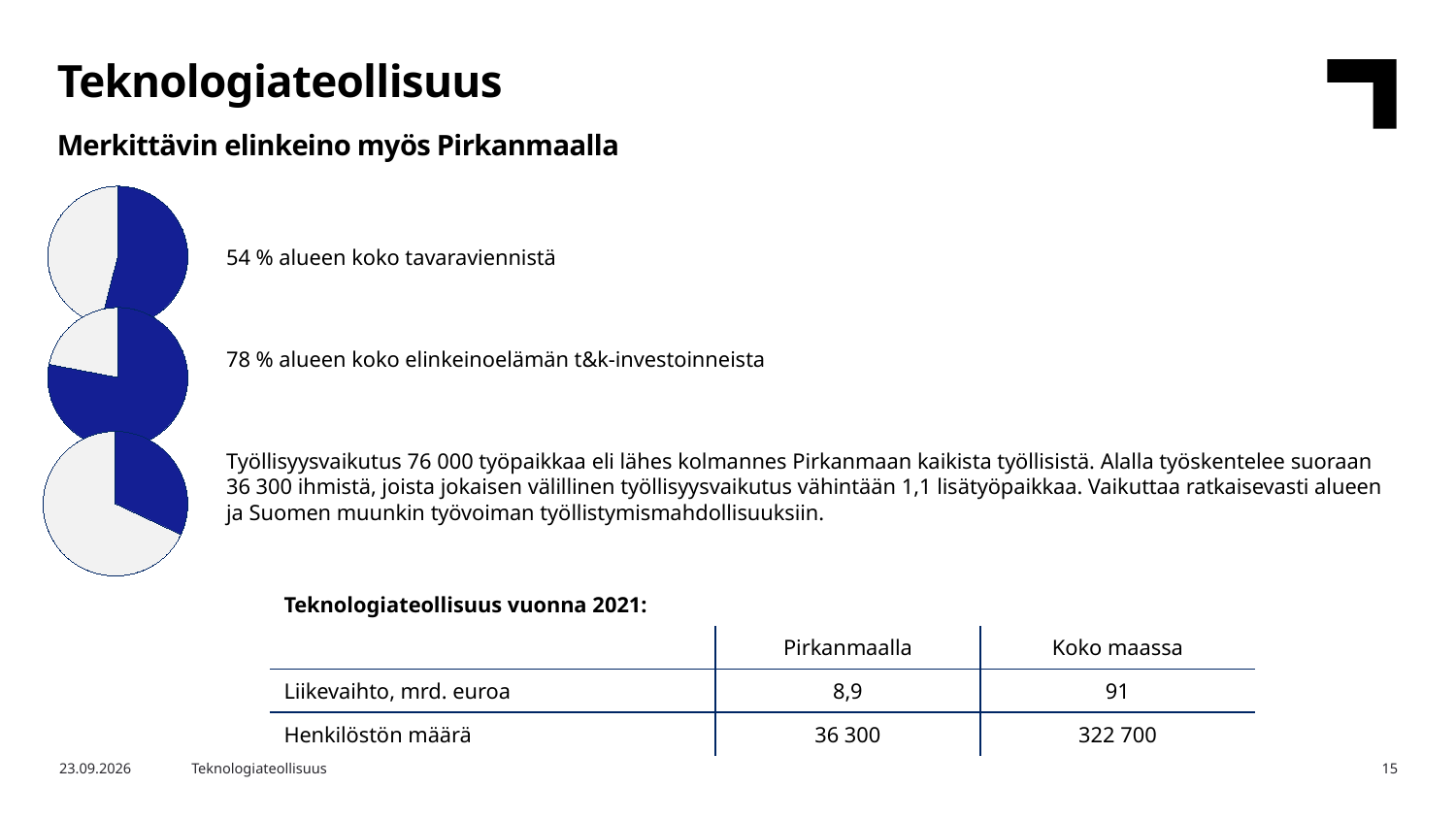
How many pie charts are on the slide? 3 In the middle pie chart, what share of the region's business R&D investments does the blue slice represent? 78 % What colour is used for the highlighted slice in each pie chart? Blue Is the blue slice in the bottom pie chart greater or less than 50%? less Which is larger: the blue slice in the top pie chart or the blue slice in the bottom pie chart? Top pie chart Is the blue slice in the middle pie chart greater or less than 50%? greater How many slices does the top pie chart have? 2 What is the difference in percentage points between the blue slice of the middle pie chart (78 %) and the blue slice of the top pie chart (54 %)? 24 percentage points In the top pie chart, what share of the region's total goods exports does the blue slice represent? 54 % What kind of charts are shown on the left side of the slide? Pie charts Which pie chart has the largest blue slice: the top, middle or bottom one? Middle Which pie chart has the smallest blue slice: the top, middle or bottom one? Bottom